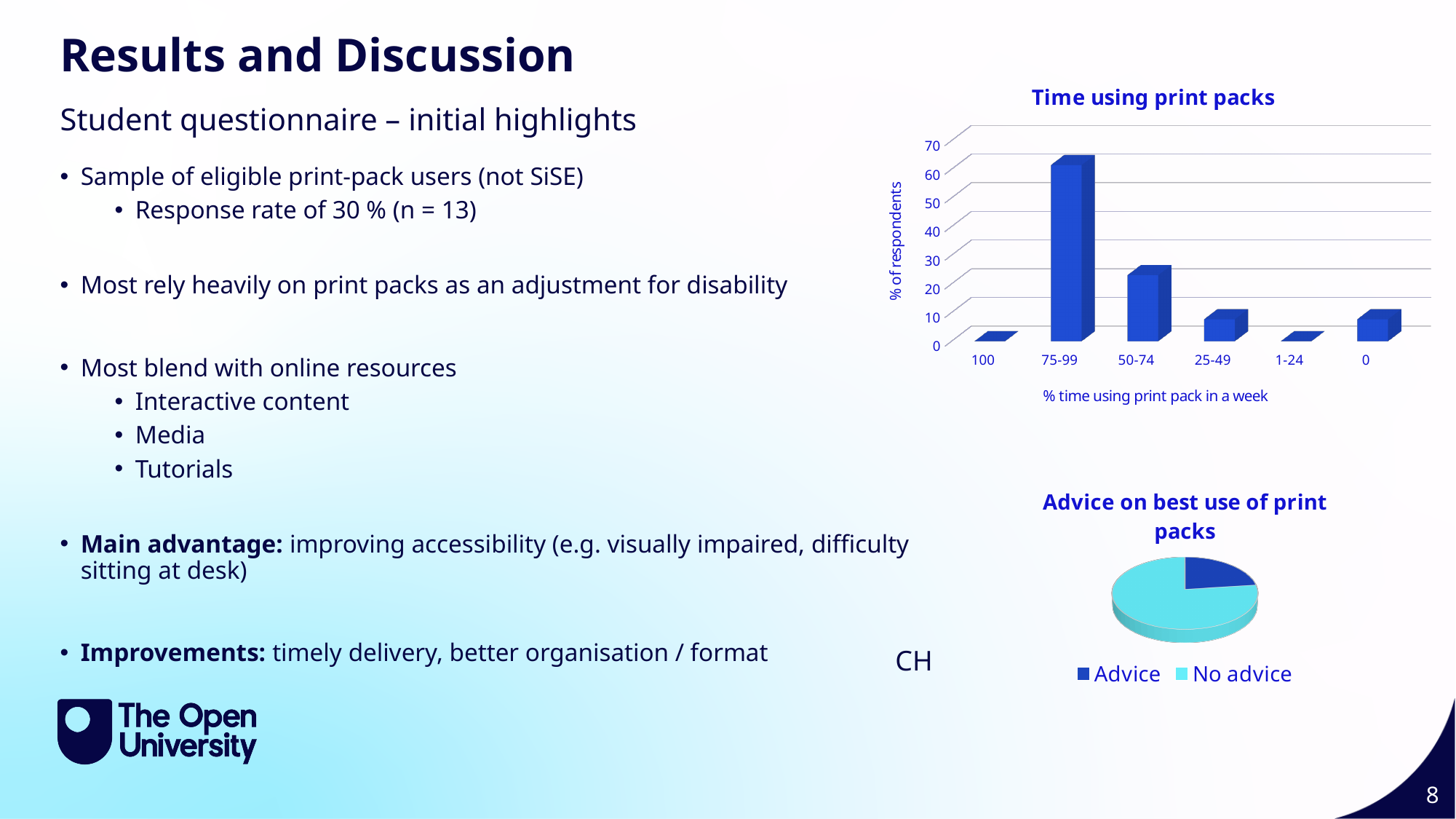
In the "Time using print packs" chart, is the value for 75-99 greater or less than 50? greater How many entries does the legend of the "Advice on best use of print packs" chart list? 2 What is the y-axis label of the "Time using print packs" chart? % of respondents In the "Time using print packs" chart, which category has the highest percentage of respondents? 75-99 What type of chart is "Time using print packs"? bar chart In the "Time using print packs" chart, which is larger: the value for 75-99 or the value for 50-74? 75-99 What type of chart is "Advice on best use of print packs"? pie chart What is the x-axis label of the "Time using print packs" chart? % time using print pack in a week In the "Time using print packs" chart, is the value for 50-74 greater or less than 30? less How many categories are shown on the x axis of the "Time using print packs" chart? 6 In the "Advice on best use of print packs" chart, which slice is larger: Advice or No advice? No advice In the "Time using print packs" chart, is the value for 25-49 greater or less than 20? less